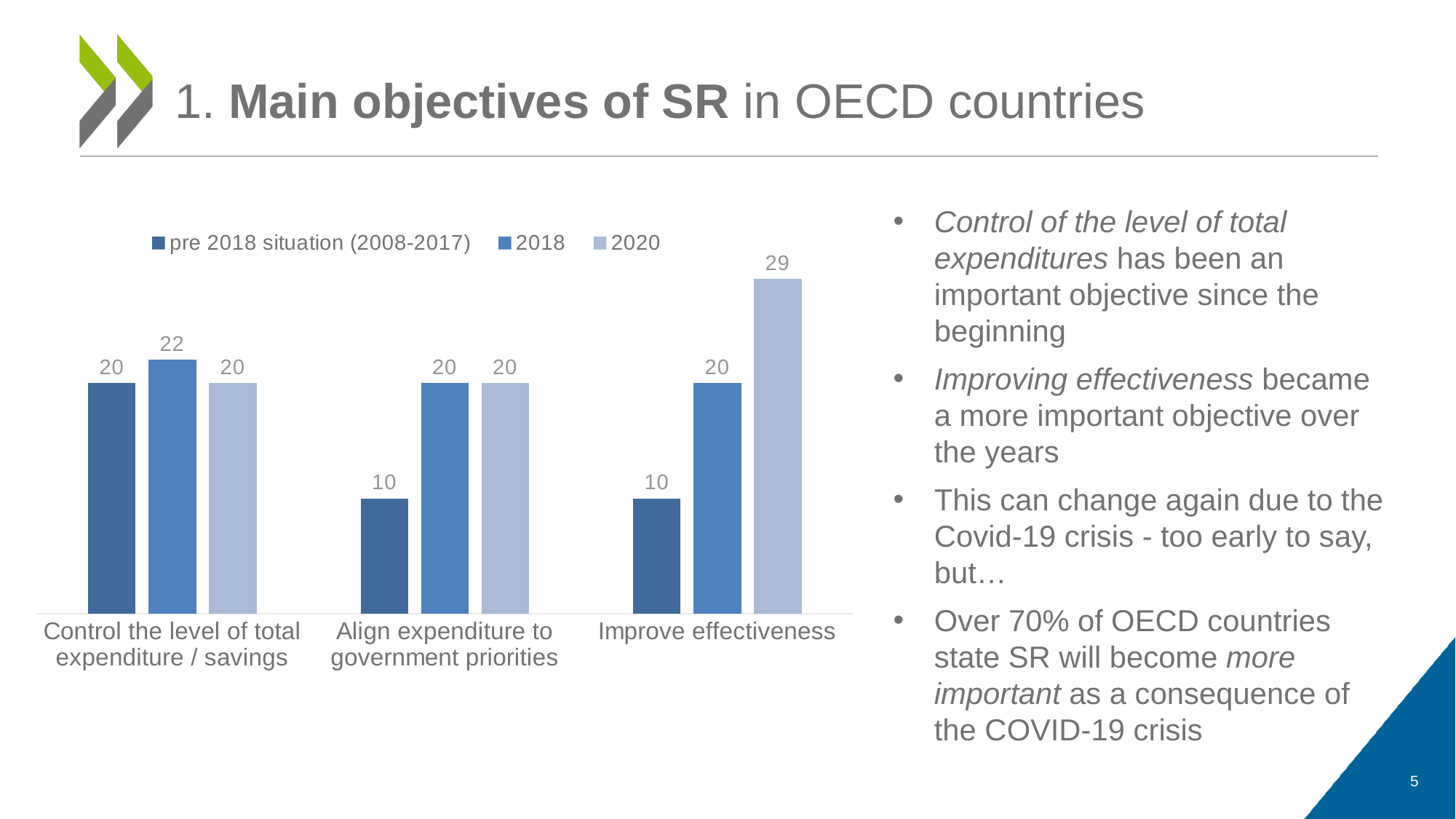
What is the 2018 value for Control the level of total expenditure / savings? 22 What is the 2020 value for Improve effectiveness? 29 What kind of chart is shown on the slide? Bar chart What is the pre 2018 situation (2008-2017) value for Align expenditure to government priorities? 10 Which is larger for Control the level of total expenditure / savings: the 2018 value or the 2020 value? 2018 Which category has the lowest 2018 value? Align expenditure to government priorities and Improve effectiveness (both 20) How many series does the legend list? 3 What is the difference between the 2020 and pre 2018 situation (2008-2017) values for Improve effectiveness? 19 Which category has the highest 2020 value? Improve effectiveness What is the first series listed in the legend? pre 2018 situation (2008-2017) Do the values for Improve effectiveness rise or fall from the pre 2018 situation to 2020? Rise How many categories are shown on the x axis? 3